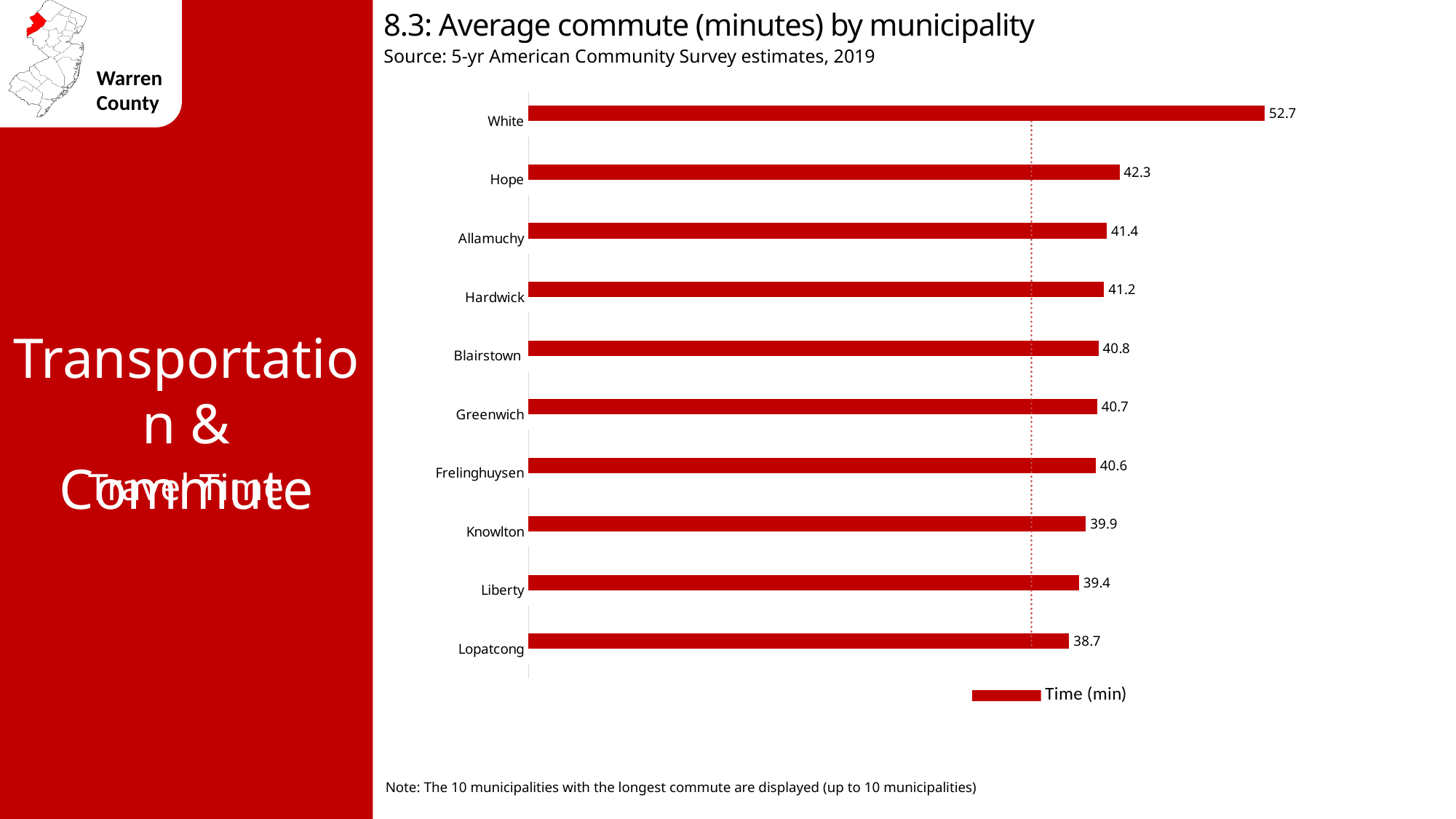
What is the average commute time for White? 52.7 What is the legend entry for the series in the chart? Time (min) Which municipality has the longest average commute? White What is the average commute time for Knowlton? 39.9 What is the difference in average commute time between White and Hope? 10.4 How many series does the legend list? 1 How many municipalities are shown in the chart? 10 What kind of chart is shown on the slide? Bar chart What is the average commute time for Greenwich? 40.7 Which has a longer average commute, Hope or Allamuchy? Hope Which municipality shown has the shortest average commute? Lopatcong What is the difference in average commute time between Liberty and Lopatcong? 0.7